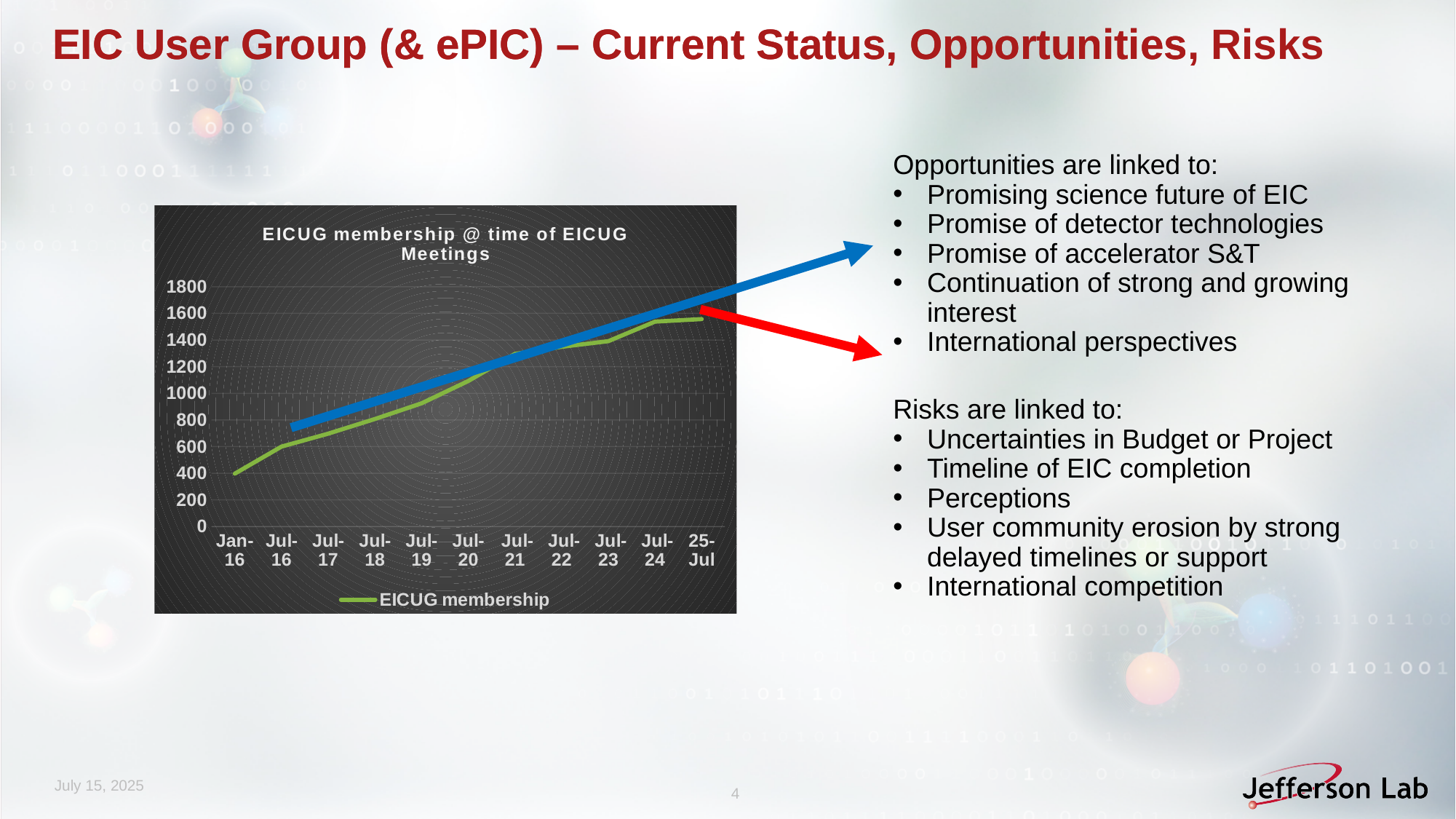
Is the EICUG membership value for Jul-24 greater or less than 1400? greater Does EICUG membership rise or fall from Jan-16 to 25-Jul along the x axis? rise What is the title of the chart on the slide? EICUG membership @ time of EICUG Meetings Is the EICUG membership value for Jul-20 greater or less than 1000? greater How many data points (meeting dates) are plotted along the x axis of the EICUG membership chart? 11 Which has the larger EICUG membership, Jul-19 or Jul-22? Jul-22 How many series does the legend of the EICUG membership chart list? 1 Is the EICUG membership value for Jul-16 greater or less than 800? less At which meeting date is EICUG membership highest? 25-Jul At which meeting date is EICUG membership lowest? Jan-16 What kind of chart is shown on the slide? line chart